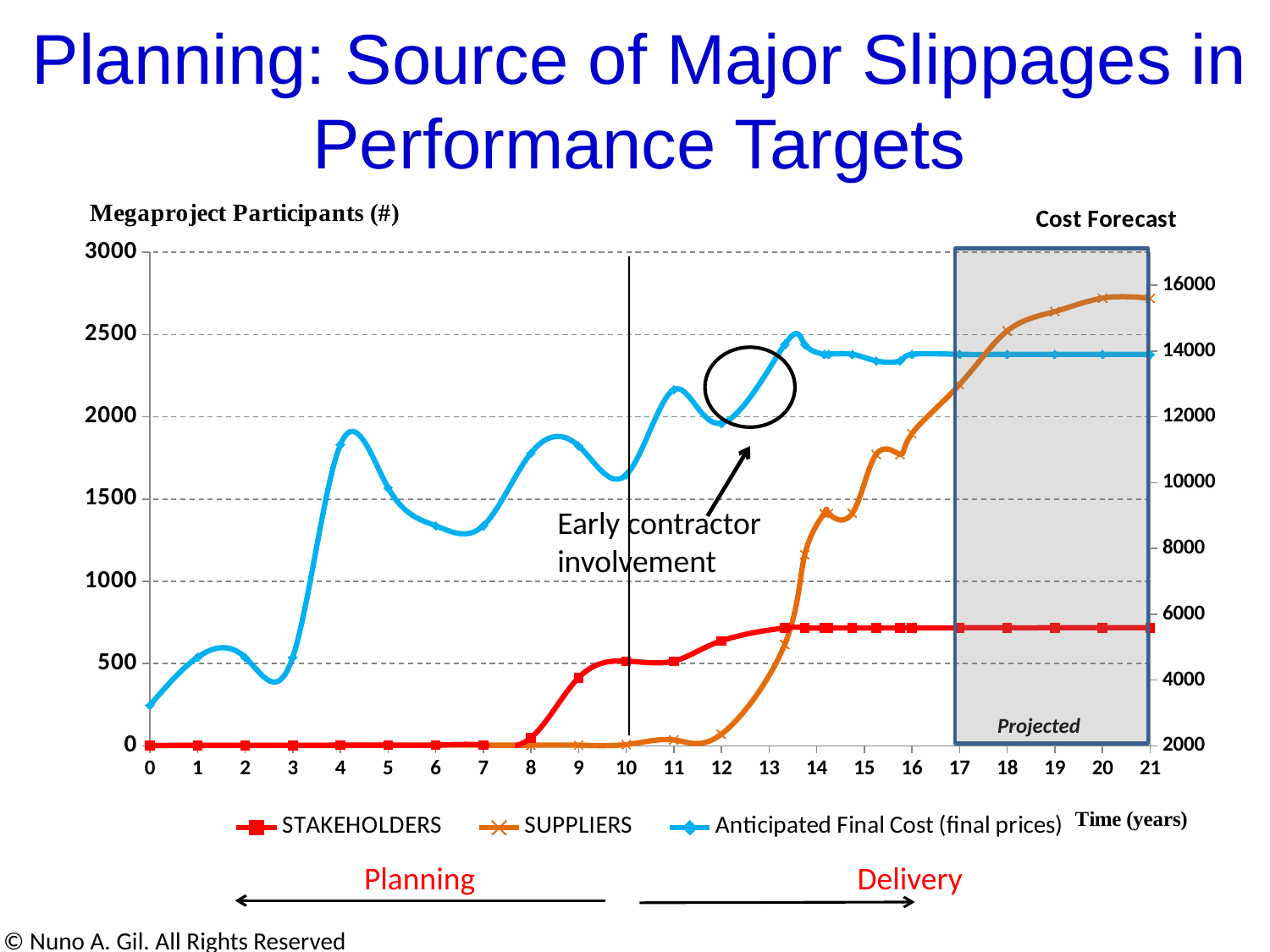
Is the SUPPLIERS value at year 14 greater or less than 1000? greater How many series does the legend list? 3 Is the SUPPLIERS value at year 20 greater or less than 2500? greater Which series reaches the highest value on the left axis (Megaproject Participants) at year 21? SUPPLIERS Is the STAKEHOLDERS value at year 14 greater or less than 500? greater Do the SUPPLIERS values rise or fall between year 12 and year 21? rise How many year ticks are shown on the x axis (from 0 to 21)? 22 What kind of chart is shown on the slide? line chart What is the title of the left vertical axis? Megaproject Participants (#) At year 18, which is larger: the SUPPLIERS value or the STAKEHOLDERS value? SUPPLIERS